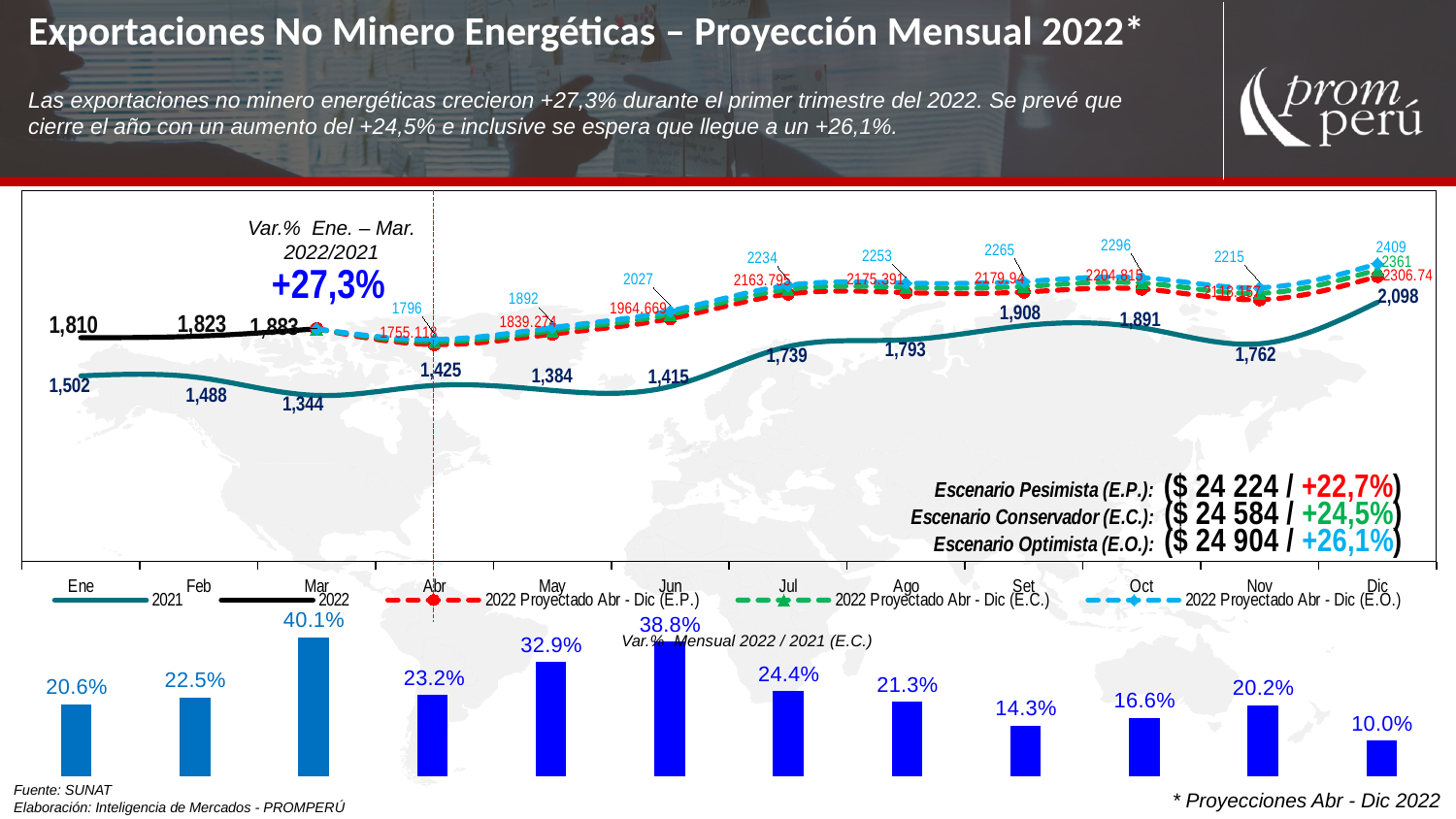
In the top line chart, what is the 2022 Proyectado Abr - Dic (E.O.) value for Dic? 2409 In the top line chart, what is the 2021 value for Mar? 1,344 How many series does the legend of the top line chart list? 5 In the top line chart, what is the 2022 value for Ene? 1,810 In the bottom bar chart, which month has the highest value? Mar In the bottom bar chart, is the value for May larger or the value for Jul? May How many bars are in the bottom bar chart? 12 In the bottom bar chart, which month has the lowest value? Dic What type of chart is the bottom chart on the slide? Bar chart In the bottom bar chart (Var.% Mensual 2022 / 2021 (E.C.)), what is the value for Mar? 40.1% In the bottom bar chart, what is the difference between the values for Jun and Set? 24.5 percentage points In the top line chart, what is the 2021 value for Dic? 2,098